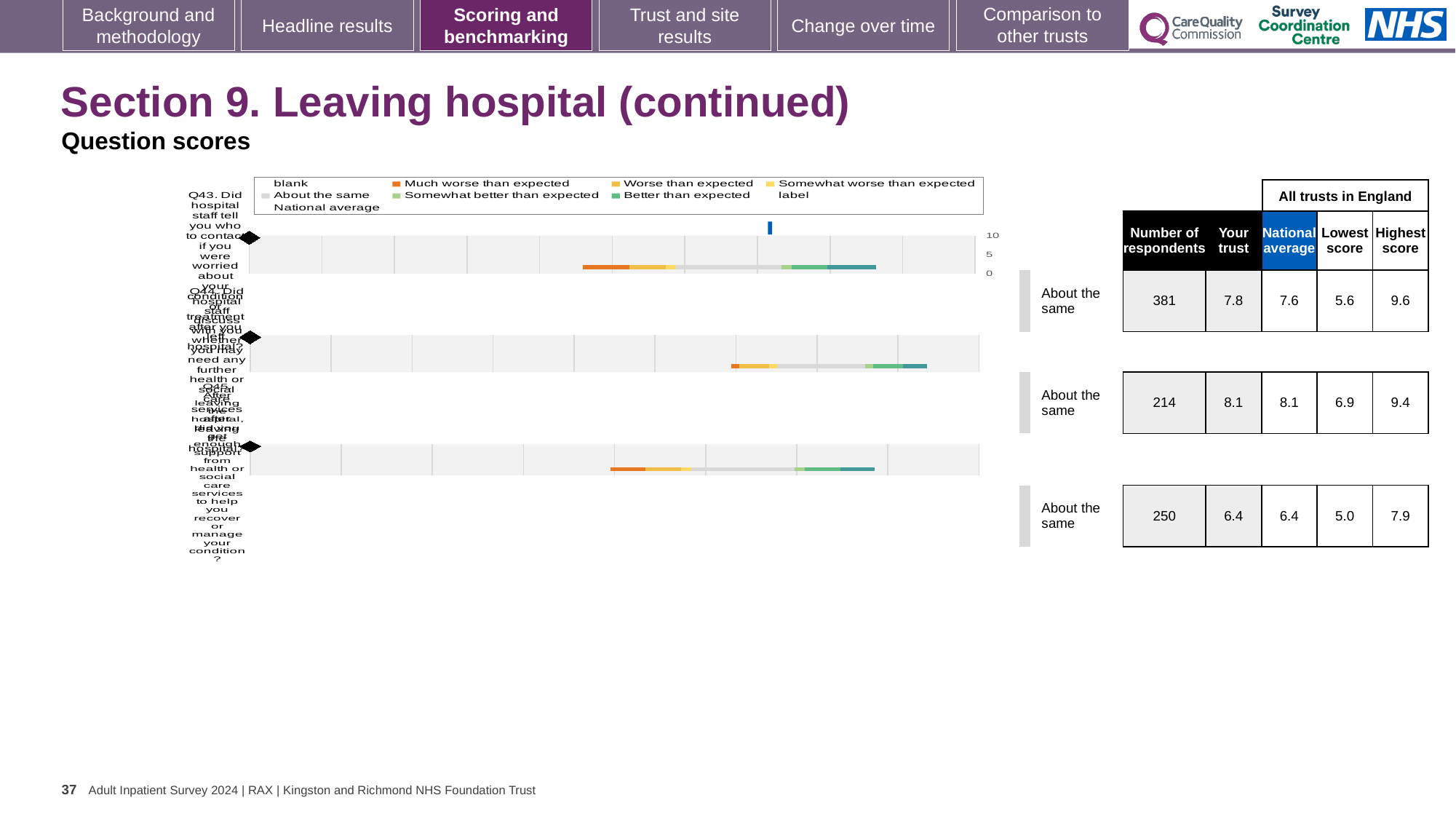
For Q43 (the first row), which is larger: the 'Your trust' score or the national average? Your trust What is the national average score for Q45 (the third row)? 6.4 Which question row has the highest 'Your trust' score? Q44 What is the lowest score among all trusts in England for Q45 (the third row)? 5.0 What kind of chart is shown on the slide? bar chart What is the number of respondents for Q43 (the first row)? 381 For Q43 (the first row), what is the difference between the 'Your trust' score and the national average? 0.2 Which question row has the lowest number of respondents? Q44 What benchmark category label is shown next to each of the three question rows? About the same What is the 'Your trust' score for Q44 (the second row)? 8.1 How many questions (bars) are plotted in the chart? 3 What is the highest score among all trusts in England for Q43 (the first row)? 9.6